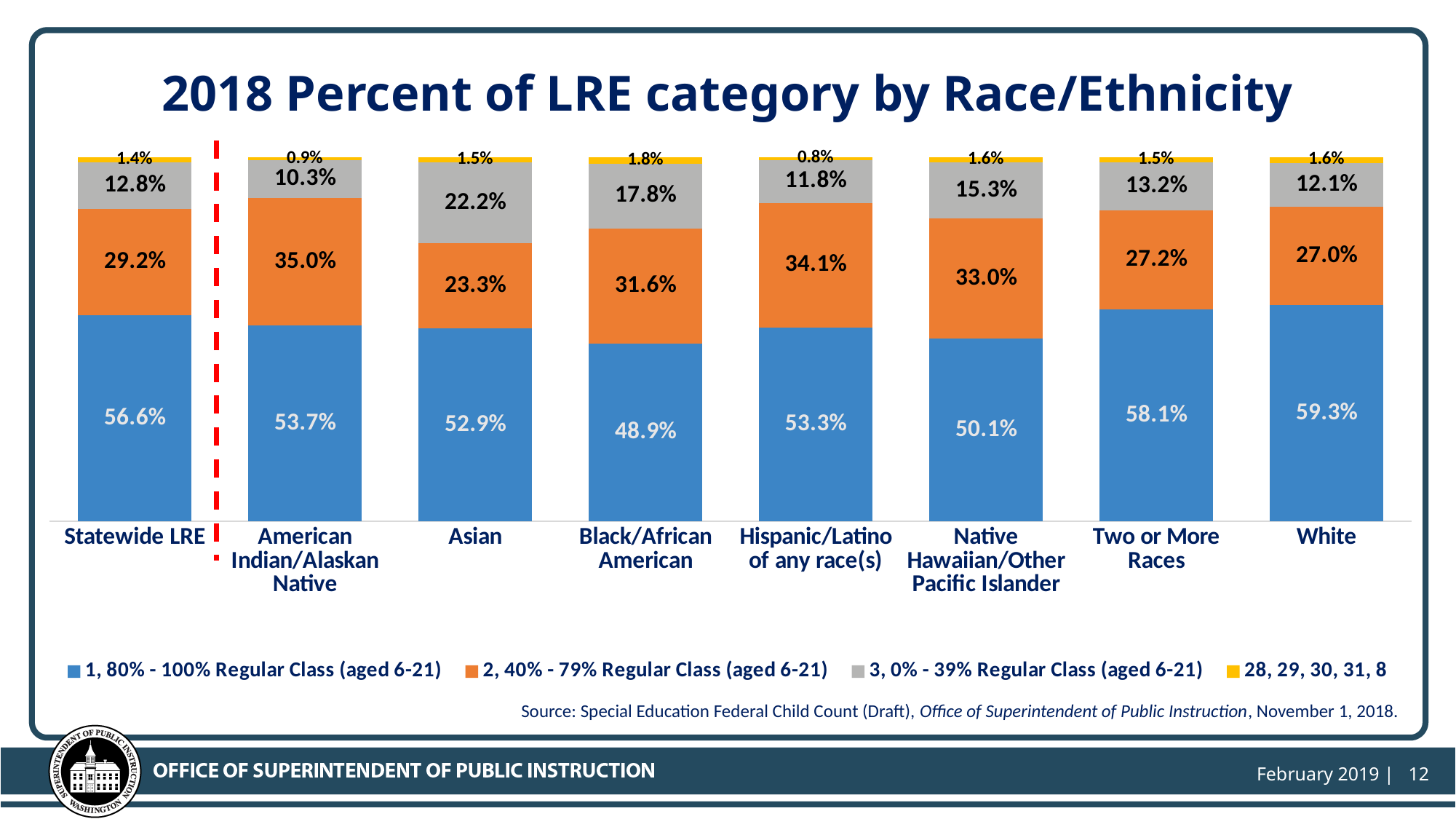
What is the difference between the "1, 80% - 100% Regular Class (aged 6-21)" values for White and Black/African American? 10.4 percentage points What is the value of the yellow top segment for Black/African American? 1.8% What is the value of the "2, 40% - 79% Regular Class (aged 6-21)" series for Hispanic/Latino of any race(s)? 34.1% What is the value of the "3, 0% - 39% Regular Class (aged 6-21)" series for Asian? 22.2% Which category has the lowest value for the "1, 80% - 100% Regular Class (aged 6-21)" series? Black/African American Which category has the highest value for the "1, 80% - 100% Regular Class (aged 6-21)" series? White How many categories are shown on the x axis? 8 Which is larger: the "3, 0% - 39% Regular Class (aged 6-21)" value for Asian or for Statewide LRE? Asian What is the value of the "1, 80% - 100% Regular Class (aged 6-21)" series for White? 59.3% Which category has the highest value for the "2, 40% - 79% Regular Class (aged 6-21)" series? American Indian/Alaskan Native How many series does the legend list? 4 What kind of chart is shown on the slide? Stacked bar chart